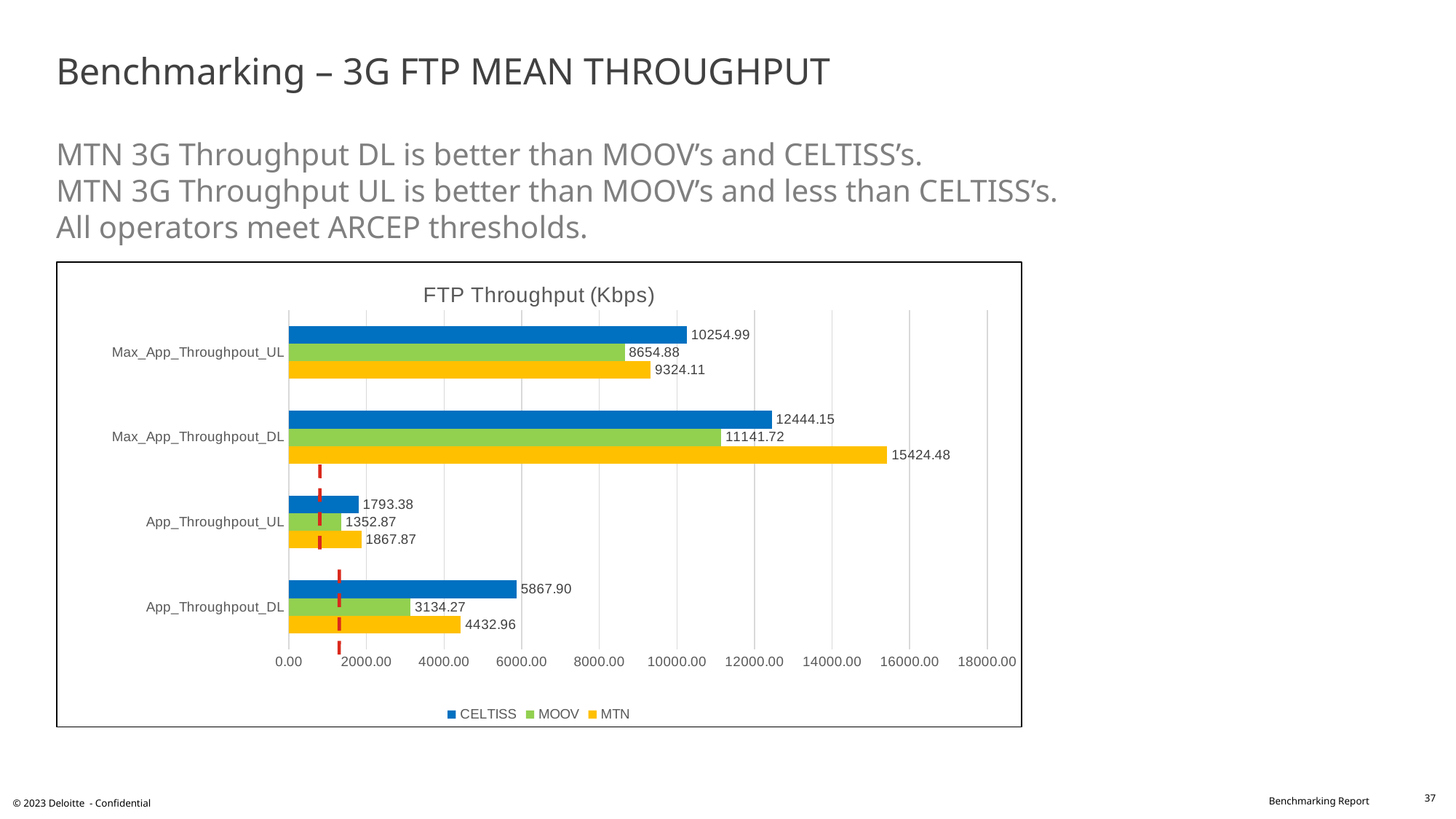
What kind of chart is shown on the slide? Bar chart What is the difference between the MTN and CELTISS values for Max_App_Throughpout_DL? 2980.33 What is the difference between the CELTISS and MOOV values for App_Throughpout_DL? 2733.63 What is the MOOV value for App_Throughpout_DL? 3134.27 What is the MTN value for Max_App_Throughpout_DL? 15424.48 Which operator has the highest value for Max_App_Throughpout_DL? MTN How many series does the legend list? 3 Which operator has the lowest value for App_Throughpout_UL? MOOV What is the CELTISS value for Max_App_Throughpout_UL in the FTP Throughput (Kbps) chart? 10254.99 For Max_App_Throughpout_UL, which is larger: the CELTISS value or the MTN value? CELTISS What is the title of the chart? FTP Throughput (Kbps) How many categories are shown on the y axis of the chart? 4